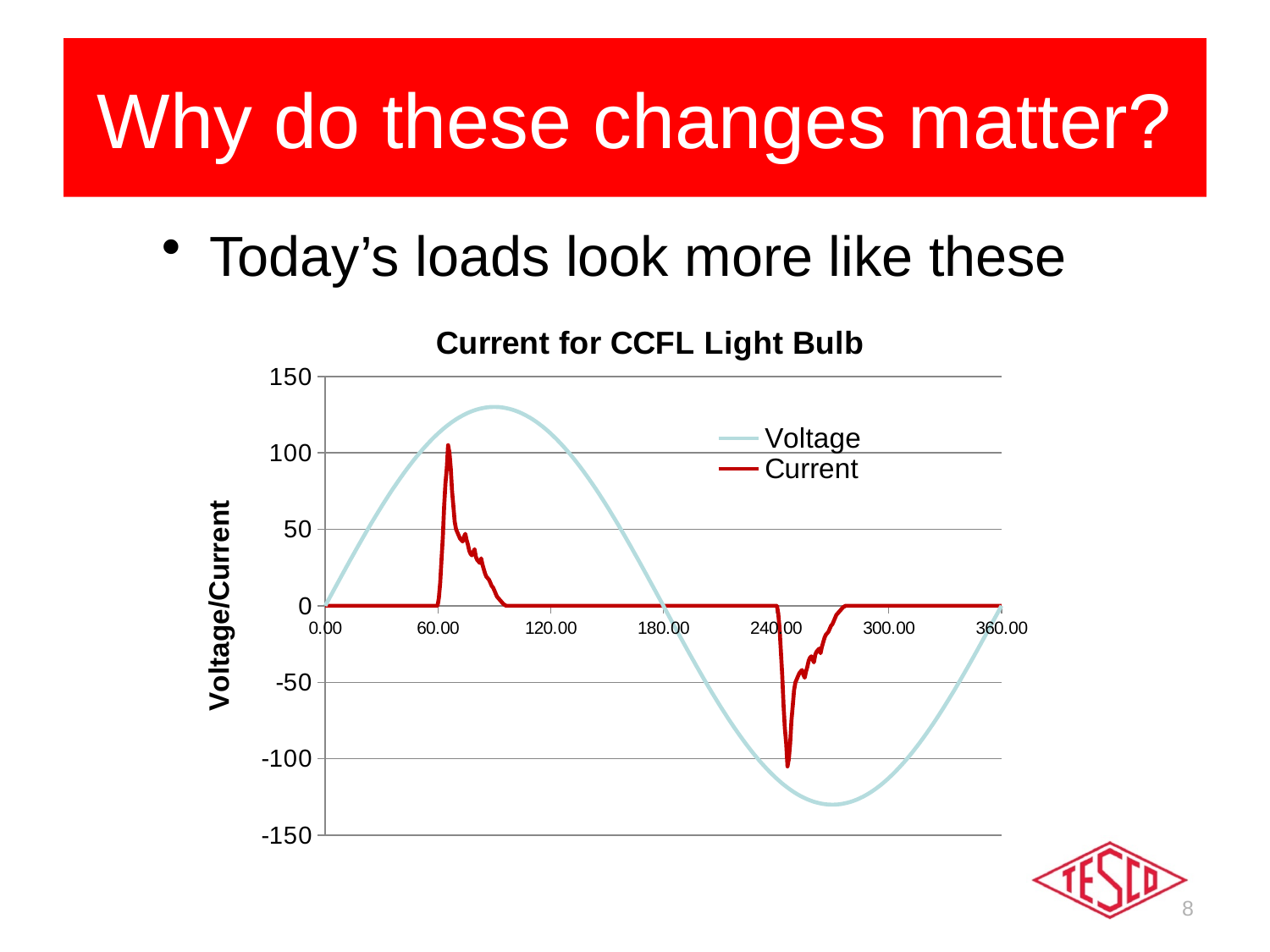
What is the title of the chart? Current for CCFL Light Bulb Is the value of the Current series at 120.00 on the x axis greater or less than 50? less Is the peak value of the Voltage series greater or less than 100? greater How many series does the chart's legend list? 2 Is the minimum value of the Voltage series greater or less than -100? less Which series reaches the higher peak value, Voltage or Current? Voltage Does the Voltage series rise or fall between 0.00 and 60.00 on the x axis? rise Does the Voltage series rise or fall between 120.00 and 180.00 on the x axis? fall What are the two series named in the chart's legend? Voltage and Current What kind of chart is shown on the slide? line chart